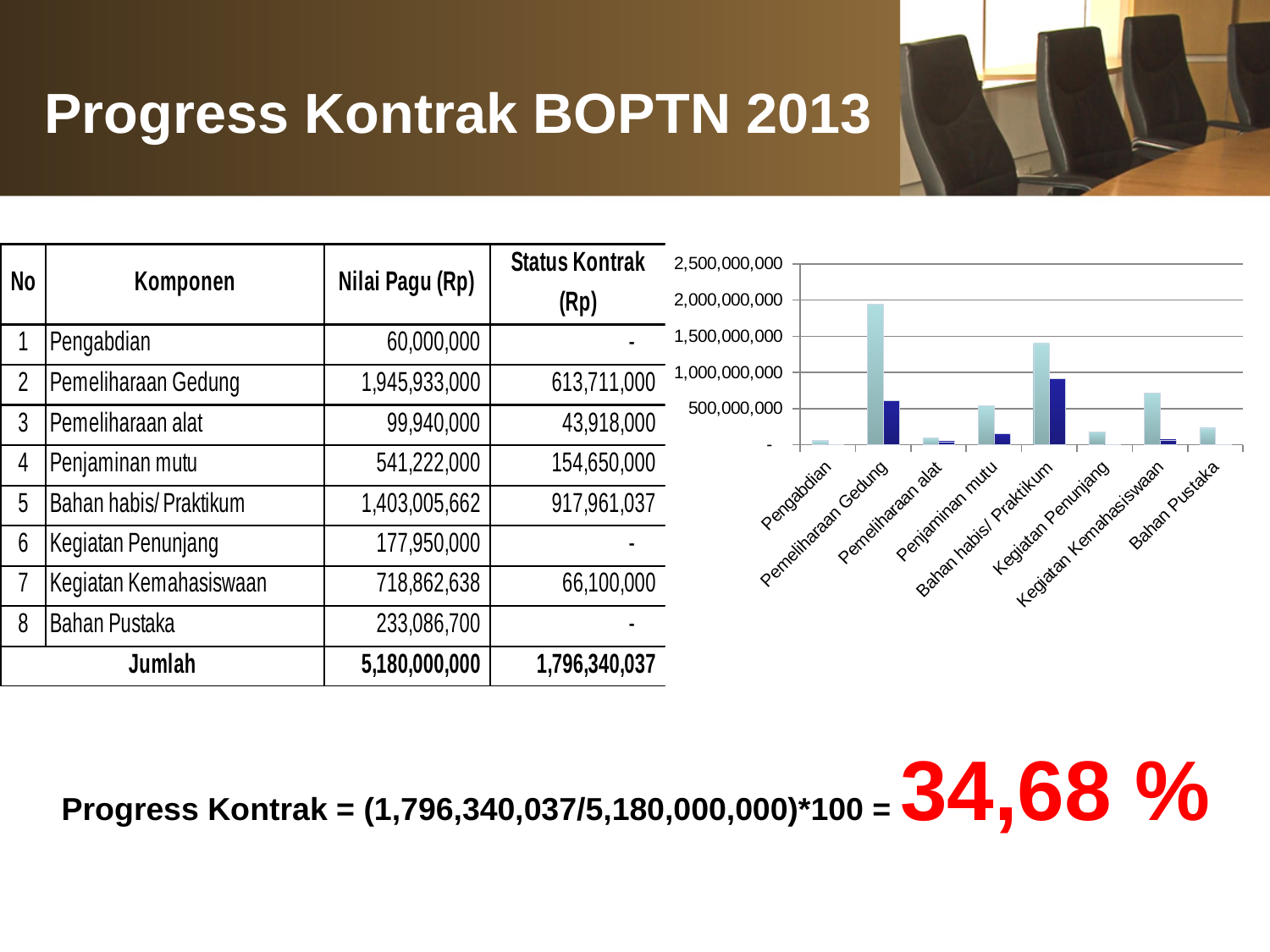
What is the highest value labelled on the chart's vertical axis? 2,500,000,000 What kind of chart is shown on the slide? bar chart Which category has the tallest bar in the chart? Pemeliharaan Gedung Which has the taller bar, Pemeliharaan Gedung or Bahan habis/ Praktikum? Pemeliharaan Gedung How many bars are plotted for the category Pemeliharaan Gedung? 2 How many categories are shown on the x axis of the chart? 8 Is the taller bar for Bahan Pustaka greater or less than 500,000,000? less Is the taller bar for Pemeliharaan Gedung greater or less than 1,500,000,000? greater Which has the taller bar, Kegiatan Kemahasiswaan or Penjaminan mutu? Kegiatan Kemahasiswaan Is the taller bar for Kegiatan Kemahasiswaan greater or less than 500,000,000? greater Which category has the shortest bars in the chart? Pengabdian